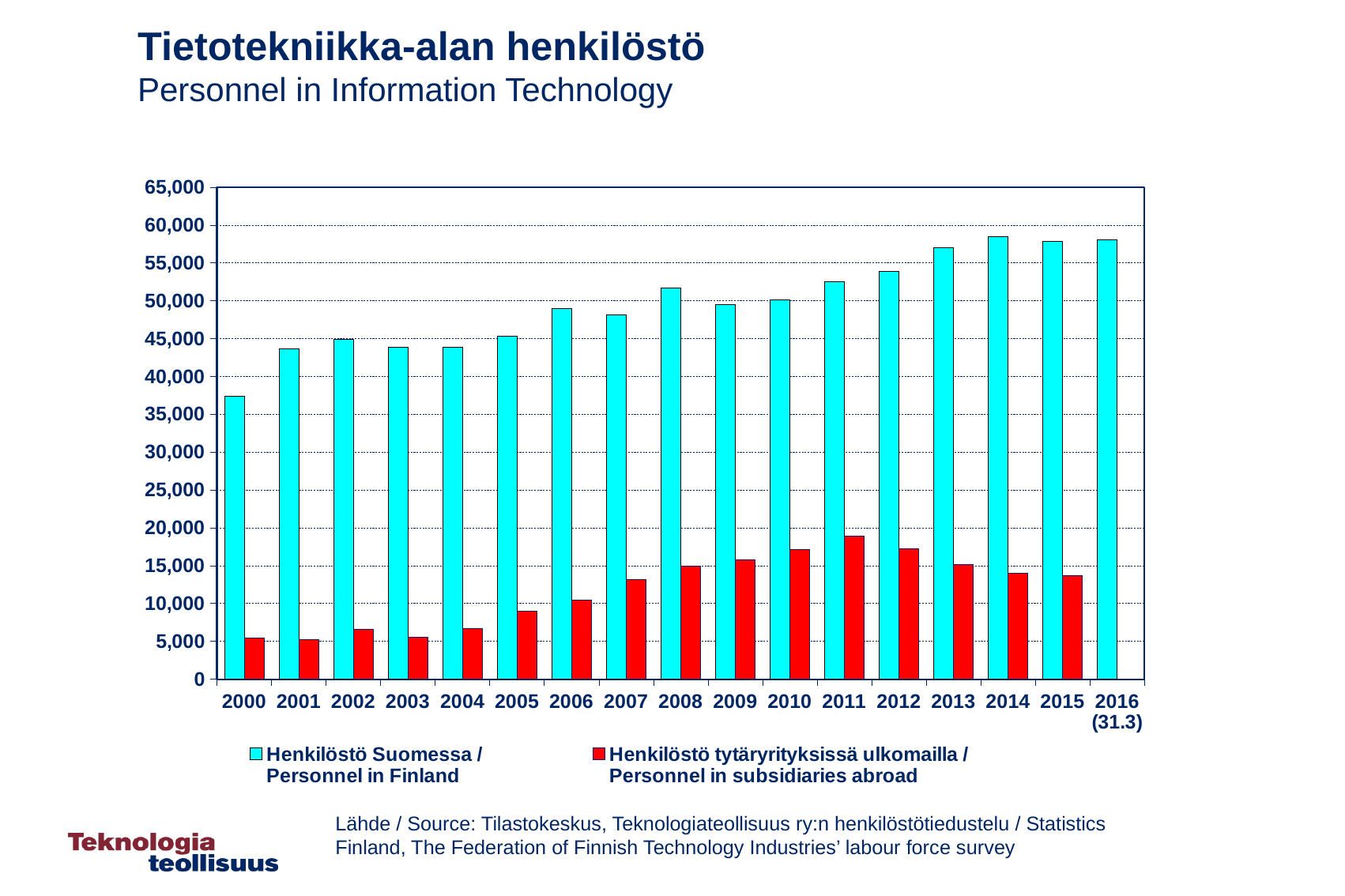
Is the value for Personnel in subsidiaries abroad in 2005 greater or less than 10,000? less Is the value for Personnel in Finland in 2000 greater or less than 40,000? less Which year has the highest value for Personnel in subsidiaries abroad? 2011 Is the value for Personnel in subsidiaries abroad in 2011 greater or less than 15,000? greater Does the value for Personnel in subsidiaries abroad rise or fall from 2011 to 2015? fall What colour are the bars for Personnel in subsidiaries abroad? red How many series does the legend list? 2 Which year has the lowest value for Personnel in Finland? 2000 How many years are shown on the x axis? 17 What kind of chart is shown on the slide? bar chart Which is larger: Personnel in subsidiaries abroad in 2006 or in 2007? 2007